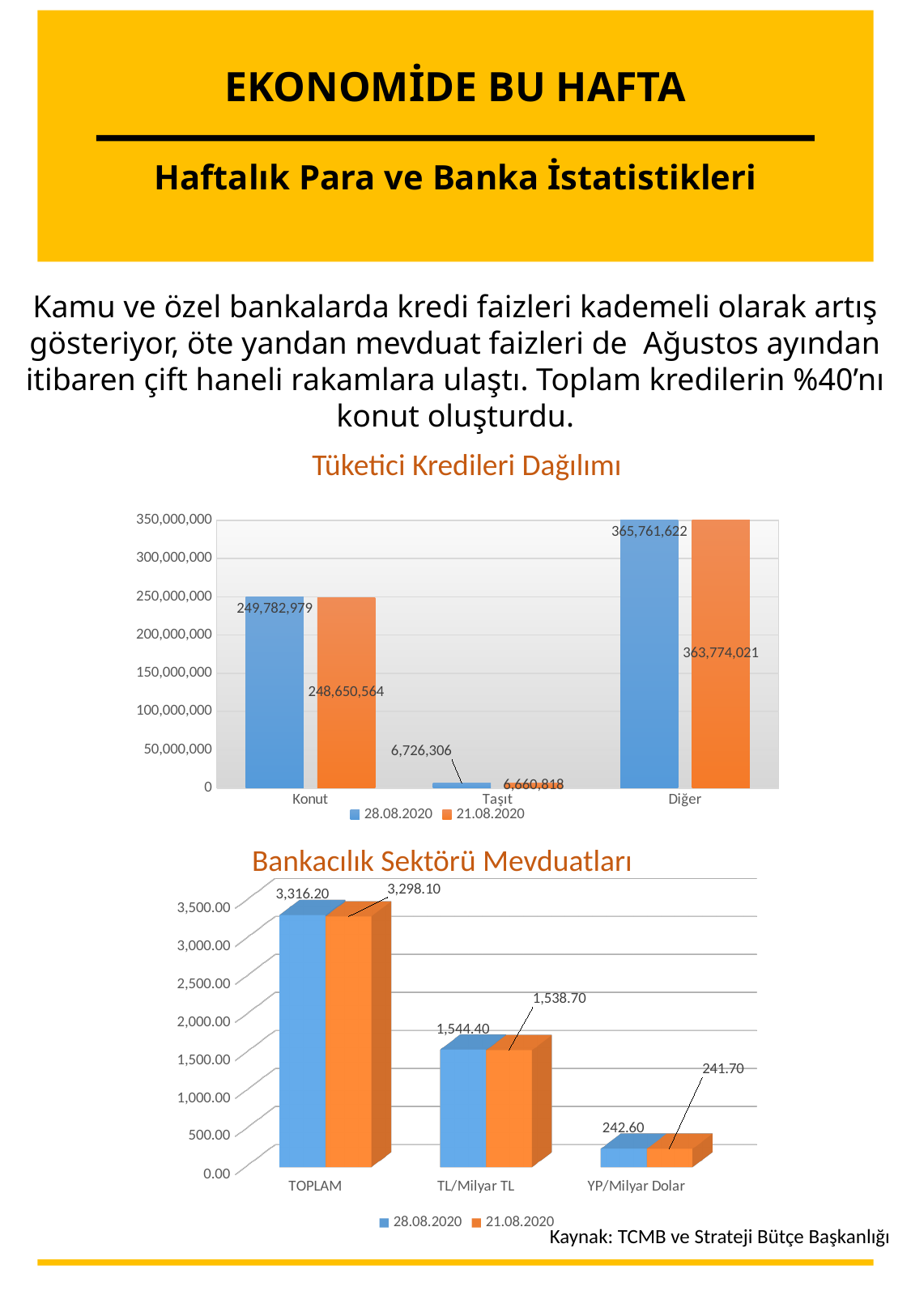
In the 'Bankacılık Sektörü Mevduatları' chart, what is the difference between the TOPLAM values for 28.08.2020 and 21.08.2020? 18.10 In the 'Bankacılık Sektörü Mevduatları' chart, what is the value for YP/Milyar Dolar on 21.08.2020? 241.70 In the 'Bankacılık Sektörü Mevduatları' chart, what is the value for TL/Milyar TL on 28.08.2020? 1,544.40 In the 'Tüketici Kredileri Dağılımı' chart, which category has the highest value on 28.08.2020? Diğer In the 'Tüketici Kredileri Dağılımı' chart, which category has the lowest value on 21.08.2020? Taşıt What kind of chart is 'Bankacılık Sektörü Mevduatları'? Bar chart In the 'Bankacılık Sektörü Mevduatları' chart, is the TOPLAM value for 28.08.2020 greater or less than 3,000.00? greater In the 'Tüketici Kredileri Dağılımı' chart, what is the value for Taşıt on 21.08.2020? 6,660,818 In the 'Tüketici Kredileri Dağılımı' chart, how many series does the legend list? 2 In the 'Tüketici Kredileri Dağılımı' chart, what is the value for Konut on 28.08.2020? 249,782,979 In the 'Bankacılık Sektörü Mevduatları' chart, how many categories are shown on the x axis? 3 In the 'Tüketici Kredileri Dağılımı' chart, what is the difference between the Konut values for 28.08.2020 and 21.08.2020? 1,132,415